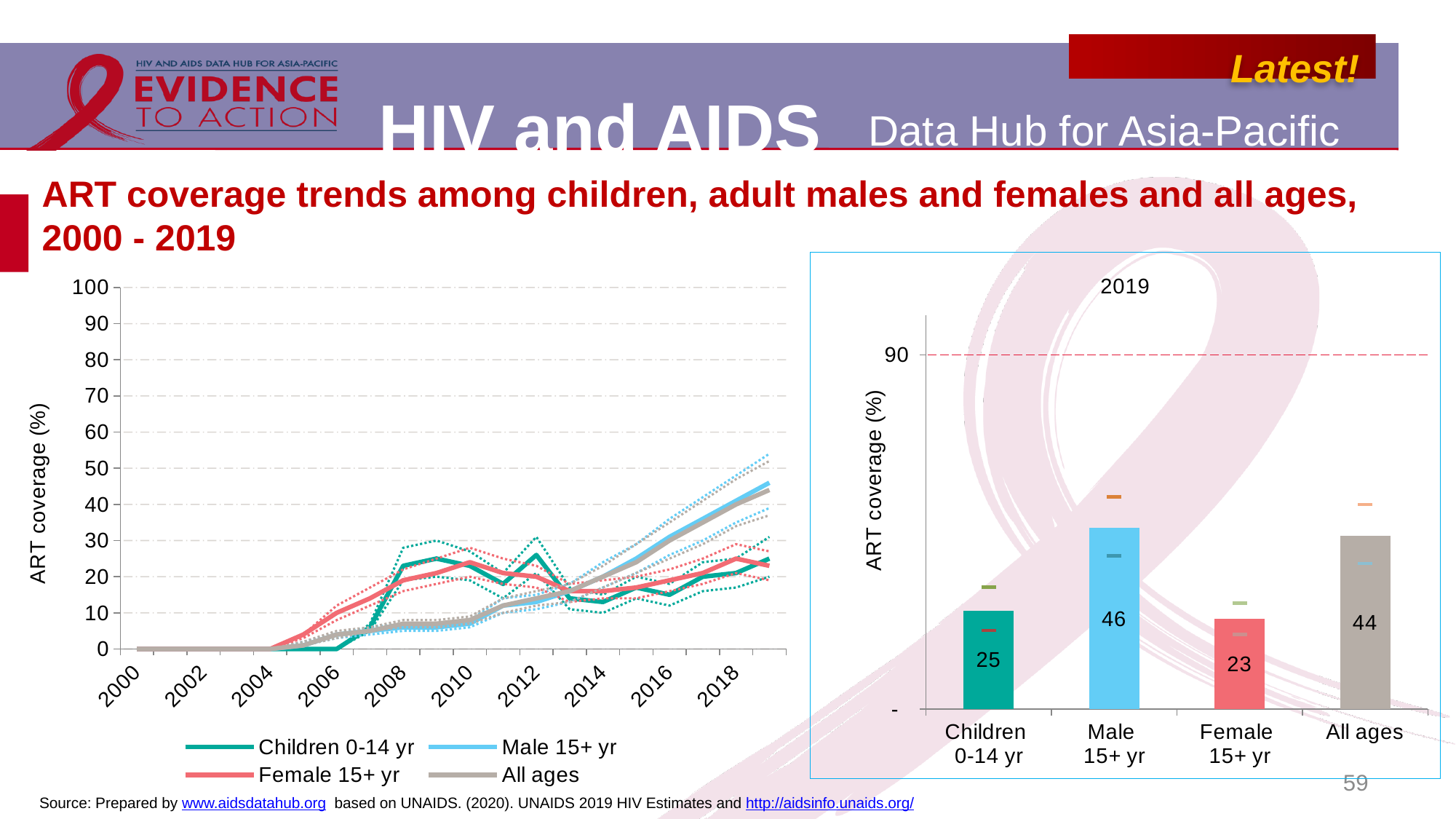
In the 2019 bar chart on the right, what is the ART coverage for Female 15+ yr? 23 In the left line chart, is the value for Male 15+ yr in 2018 greater or less than 30? greater In the left line chart, does the Male 15+ yr series rise or fall between 2014 and 2019? Rise In the 2019 bar chart on the right, which group has the lowest ART coverage? Female 15+ yr In the 2019 bar chart on the right, what is the difference in ART coverage between Male 15+ yr and Female 15+ yr? 23 In the 2019 bar chart on the right, what is the ART coverage for Male 15+ yr? 46 In the 2019 bar chart on the right, what is the ART coverage for Children 0-14 yr? 25 In the 2019 bar chart on the right, which group has the highest ART coverage? Male 15+ yr In the 2019 bar chart on the right, how many groups are shown? 4 In the 2019 bar chart on the right, what is the ART coverage for All ages? 44 What type of chart is the chart on the left showing ART coverage trends from 2000 to 2019? Line chart How many series does the legend of the left line chart list? 4